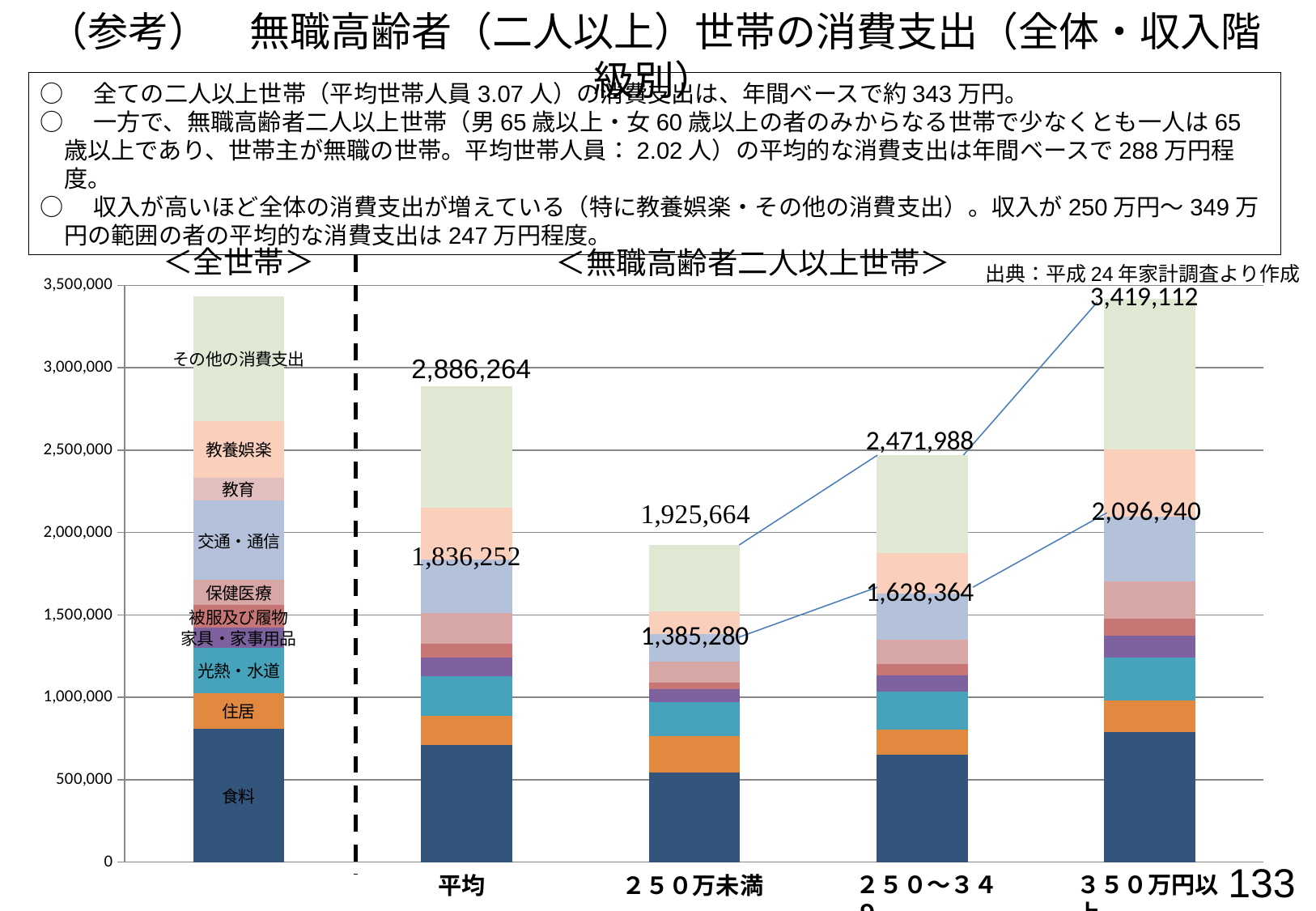
What is the difference between the totals of the ３５０万円以上 bar and the ２５０万未満 bar? 1,493,448 Do the totals rise or fall as income class increases from ２５０万未満 to ３５０万円以上? rise What is the total consumption expenditure shown for the 平均 bar in the 無職高齢者二人以上世帯 section? 2,886,264 Among the four 無職高齢者二人以上世帯 bars, which income class has the lowest total? ２５０万未満 Is the total of the 全世帯 bar greater or less than 3,000,000? greater Which is larger, the total for 平均 or the total for ２５０〜３４９? 平均 What kind of chart is shown on the slide? stacked bar chart What is the total value labelled above the ２５０万未満 bar? 1,925,664 What is the total value labelled above the ３５０万円以上 bar? 3,419,112 What is the total value labelled above the ２５０〜３４９ bar? 2,471,988 What is the difference between the totals of the ２５０〜３４９ bar and the ２５０万未満 bar? 546,324 How many bars are plotted in the chart? 5